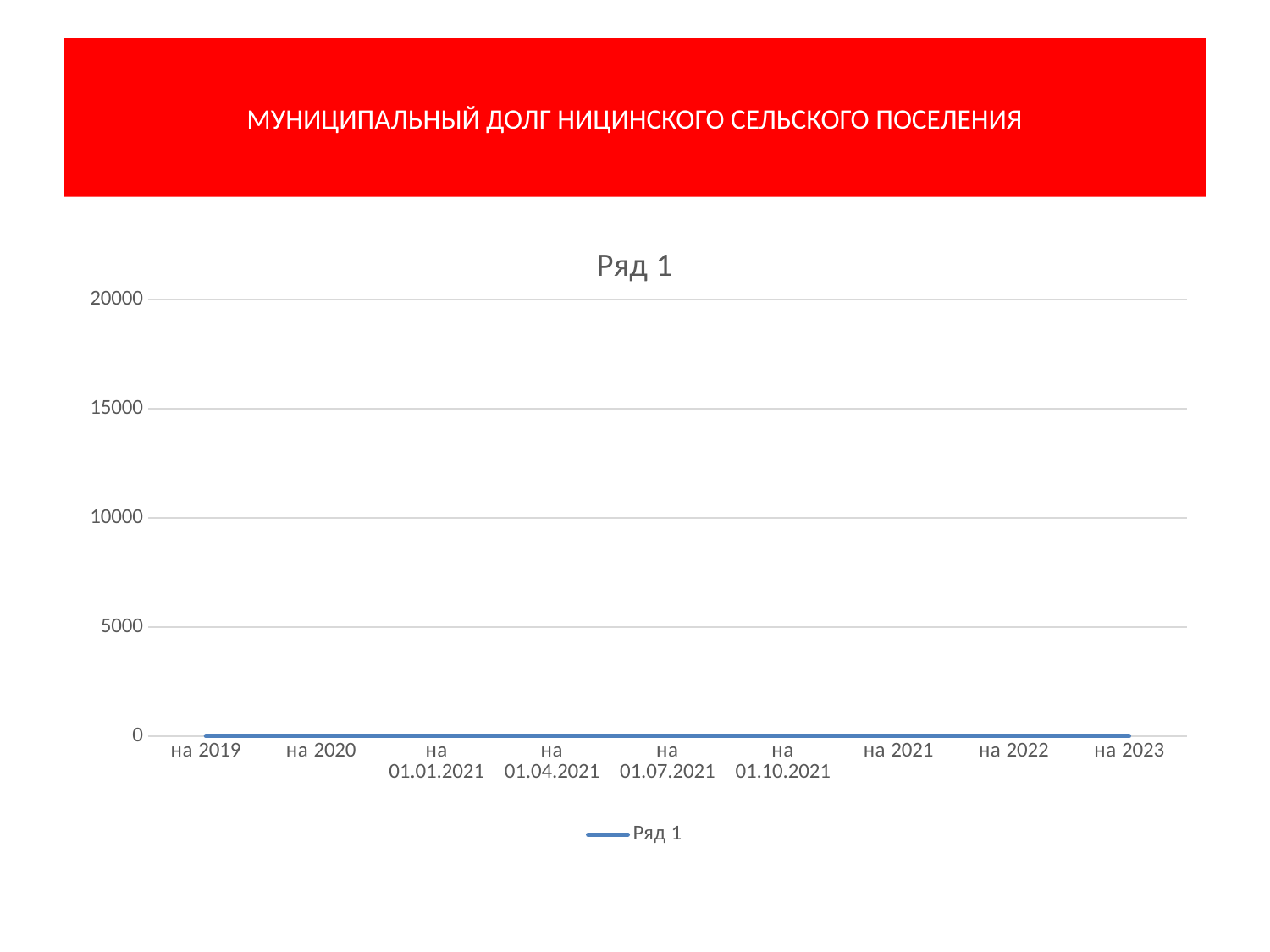
How many series does the chart legend list? 1 Is the value for "на 01.04.2021" greater or less than 10000? less What is the value for "на 01.07.2021" in the chart? 0 Do the values rise, fall, or stay flat from "на 2019" to "на 2023"? stay flat What is the value for "на 2019" in the chart? 0 What is the name of the series listed in the chart legend? Ряд 1 What is the difference between the values for "на 2020" and "на 2022"? 0 How many categories are shown along the x axis of the chart? 9 What is the title shown above the chart's plot area? Ряд 1 What kind of chart is shown on the slide? line chart Is the value for "на 2021" greater or less than 5000? less What is the value for "на 2023" in the chart? 0